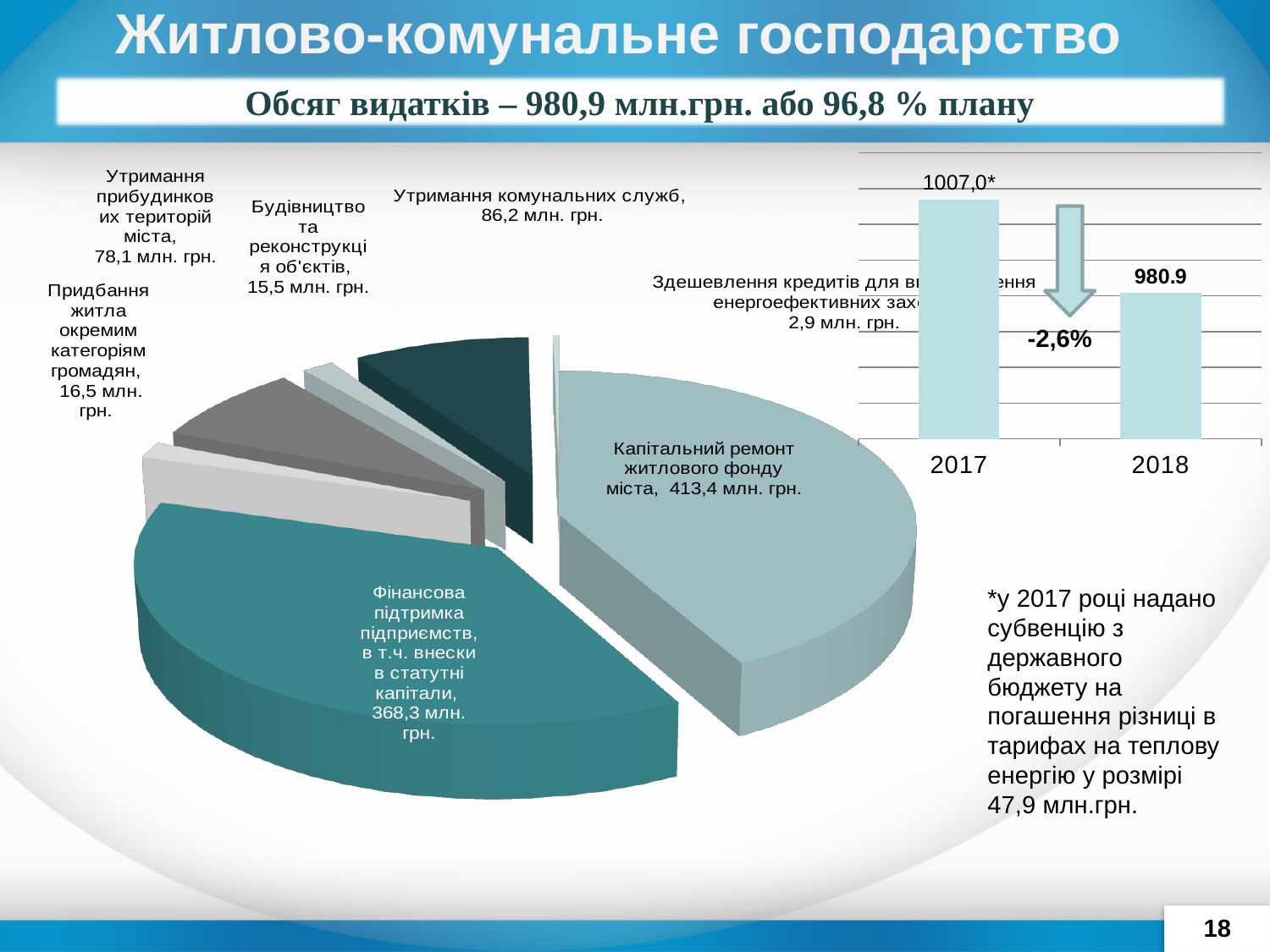
On the pie chart, how many slices are there? 7 On the pie chart, what is the value for Утримання комунальних служб? 86,2 млн. грн. On the bar chart on the right, do the values rise or fall from 2017 to 2018? fall On the pie chart, which category has the smallest value? Здешевлення кредитів для впровадження енергоефективних заходів On the bar chart on the right, what is the value for 2017? 1007,0 On the pie chart, what is the value for Фінансова підтримка підприємств, в т.ч. внески в статутні капітали? 368,3 млн. грн. On the pie chart, what is the value for Будівництво та реконструкція об'єктів? 15,5 млн. грн. On the pie chart, what is the difference between Капітальний ремонт житлового фонду міста and Фінансова підтримка підприємств? 45,1 млн. грн. On the pie chart, which category has the largest value? Капітальний ремонт житлового фонду міста On the pie chart, which is larger: Утримання прибудинкових територій міста or Придбання житла окремим категоріям громадян? Утримання прибудинкових територій міста On the pie chart, what is the value for Капітальний ремонт житлового фонду міста? 413,4 млн. грн. On the bar chart on the right, what is the value for 2018? 980.9